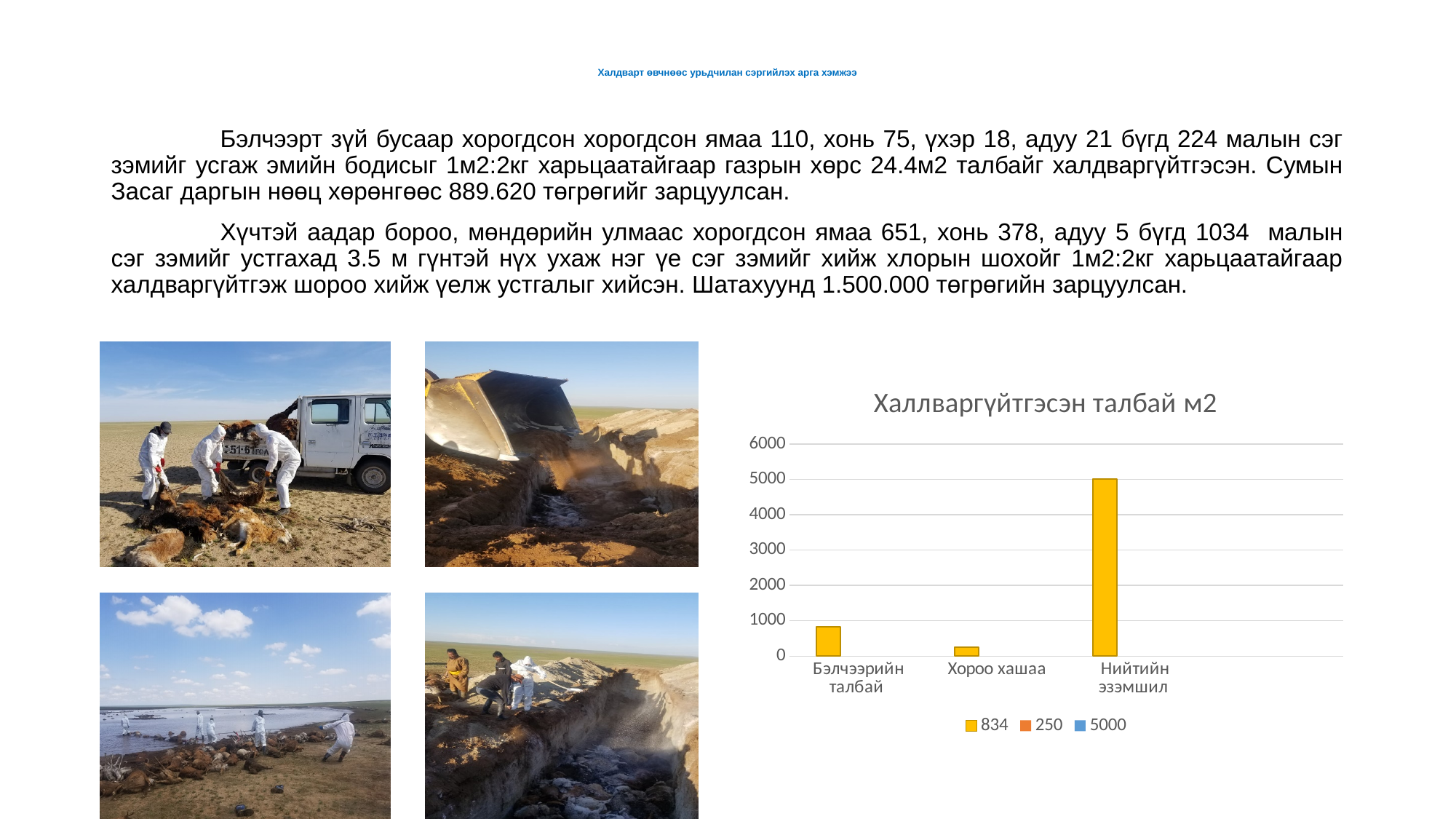
What entries are listed in the chart's legend? 834, 250, 5000 What is the value for Нийтийн эзэмшил in the chart? 5000 What is the title of the chart? Халлваргүйтгэсэн талбай м2 Which is larger, the value for Бэлчээрийн талбай or the value for Хороо хашаа? Бэлчээрийн талбай Is the value for Нийтийн эзэмшил greater or less than 4000? greater Which category has the highest bar in the chart? Нийтийн эзэмшил How many entries does the chart's legend list? 3 Is the value for Хороо хашаа greater or less than 1000? less Is the value for Бэлчээрийн талбай greater or less than 1000? less What kind of chart is shown on the slide? bar chart Which category has the lowest bar in the chart? Хороо хашаа How many categories are shown on the x axis of the chart? 3